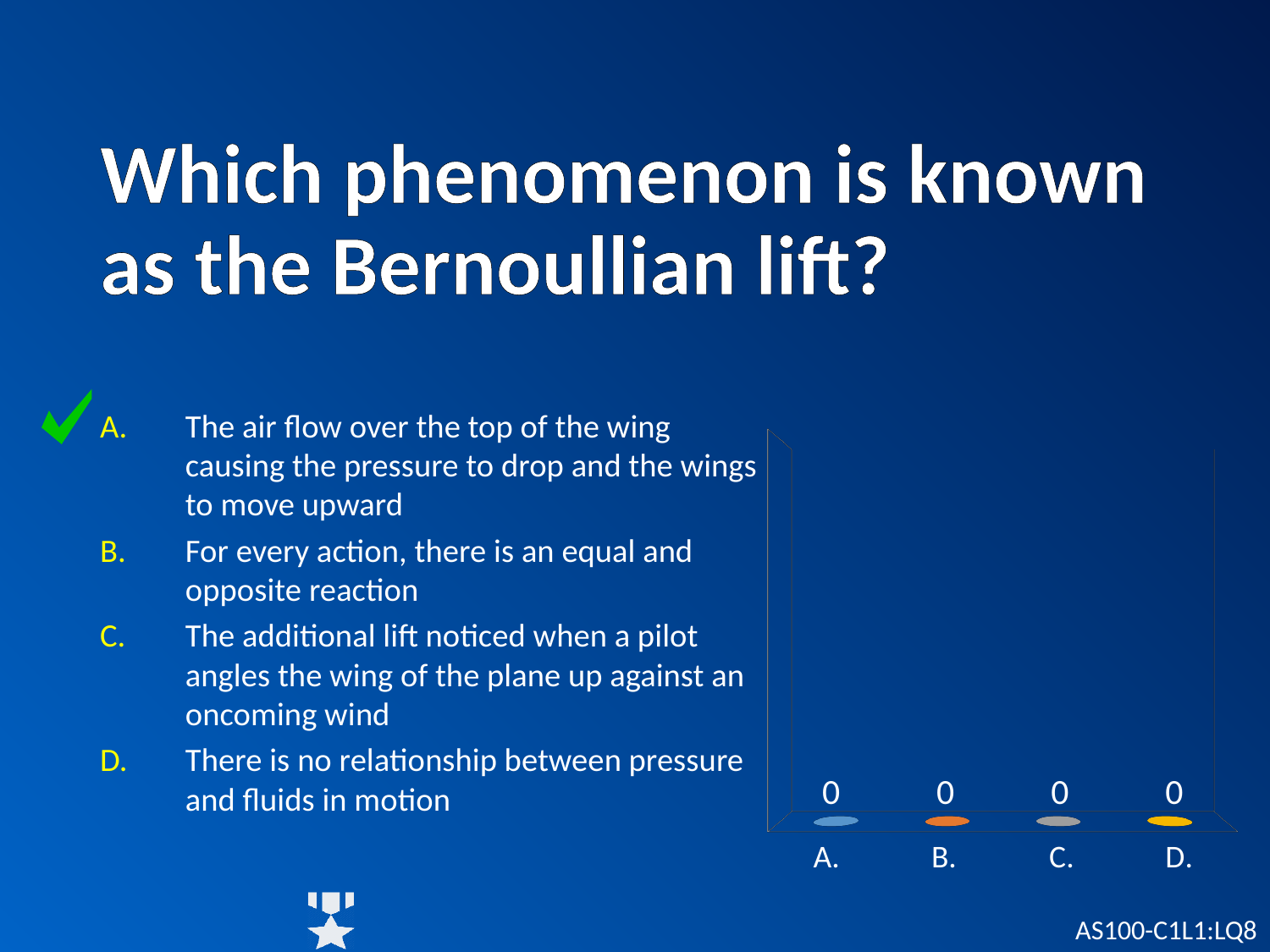
What are the category labels along the x axis of the chart? A., B., C., D. What colour is the bar for category B in the chart? orange What is the value shown for category A in the chart? 0 What is the value shown for category B in the chart? 0 What is the value shown for category D in the chart? 0 What is the value shown for category C in the chart? 0 Do the values in the chart rise, fall, or stay the same from A to D? stay the same What kind of chart is shown on the slide? bar chart How many categories are shown on the x axis of the chart? 4 What is the difference between the values for A and D in the chart? 0